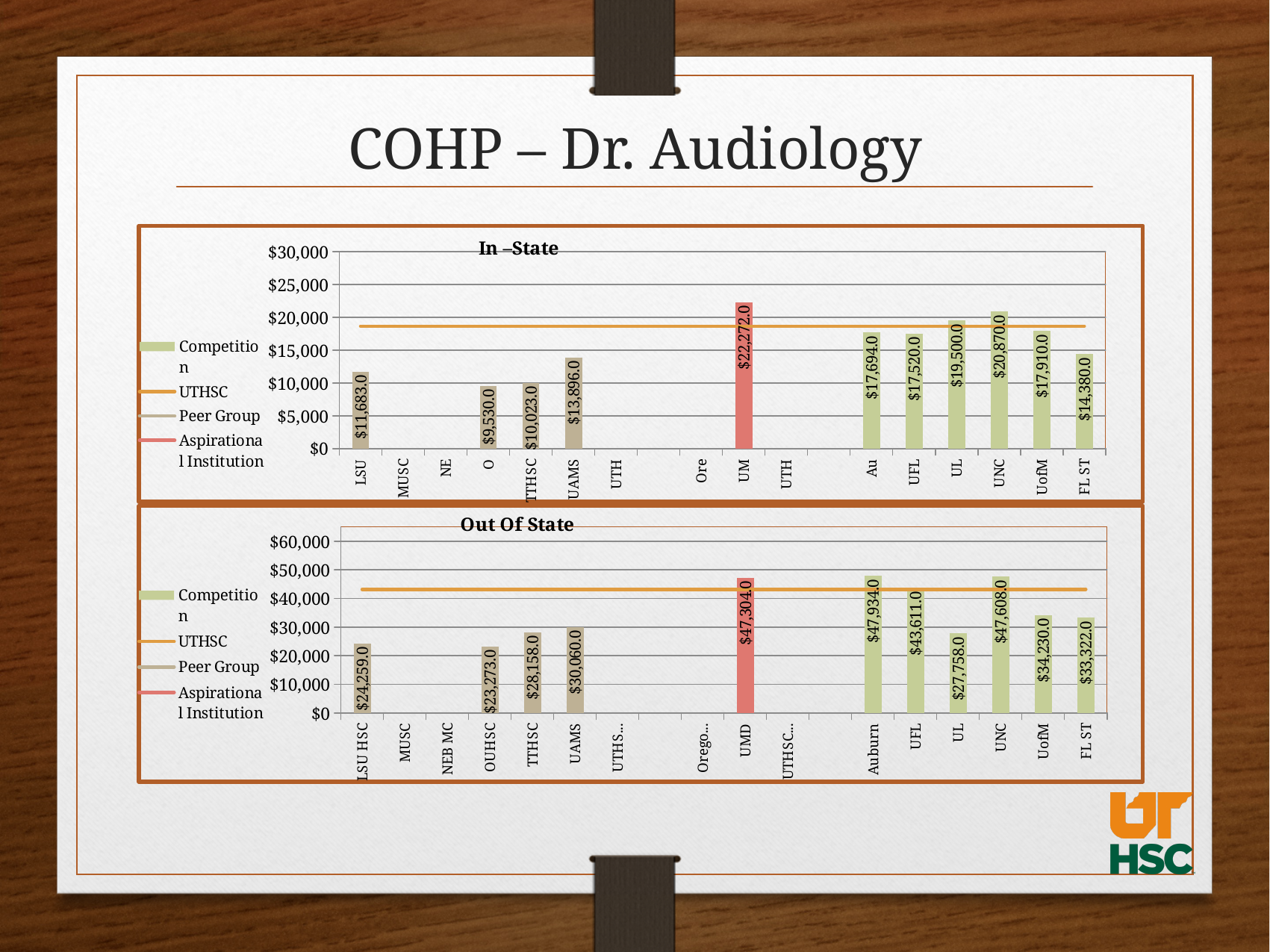
How many series does the legend of the In –State chart list? 4 In the Out Of State chart, what is the value for Auburn? $47,934.0 In the In –State chart, what is the difference between the values for UNC and UL? $1,370.0 In the In –State chart, what is the value for UM? $22,272.0 In the In –State chart, which institution has the highest bar? UM In the Out Of State chart, which institution has the lowest labelled value? OUHSC In the Out Of State chart, which is larger, the value for UofM or the value for FL ST? UofM In the Out Of State chart, is the UTHSC line greater or less than $40,000? greater What kind of chart is the Out Of State chart? bar chart In the Out Of State chart, what is the difference between the values for UAMS and TTHSC? $1,902.0 In the In –State chart, what is the value for UAMS? $13,896.0 In the In –State chart, which institution has the lowest labelled value? O